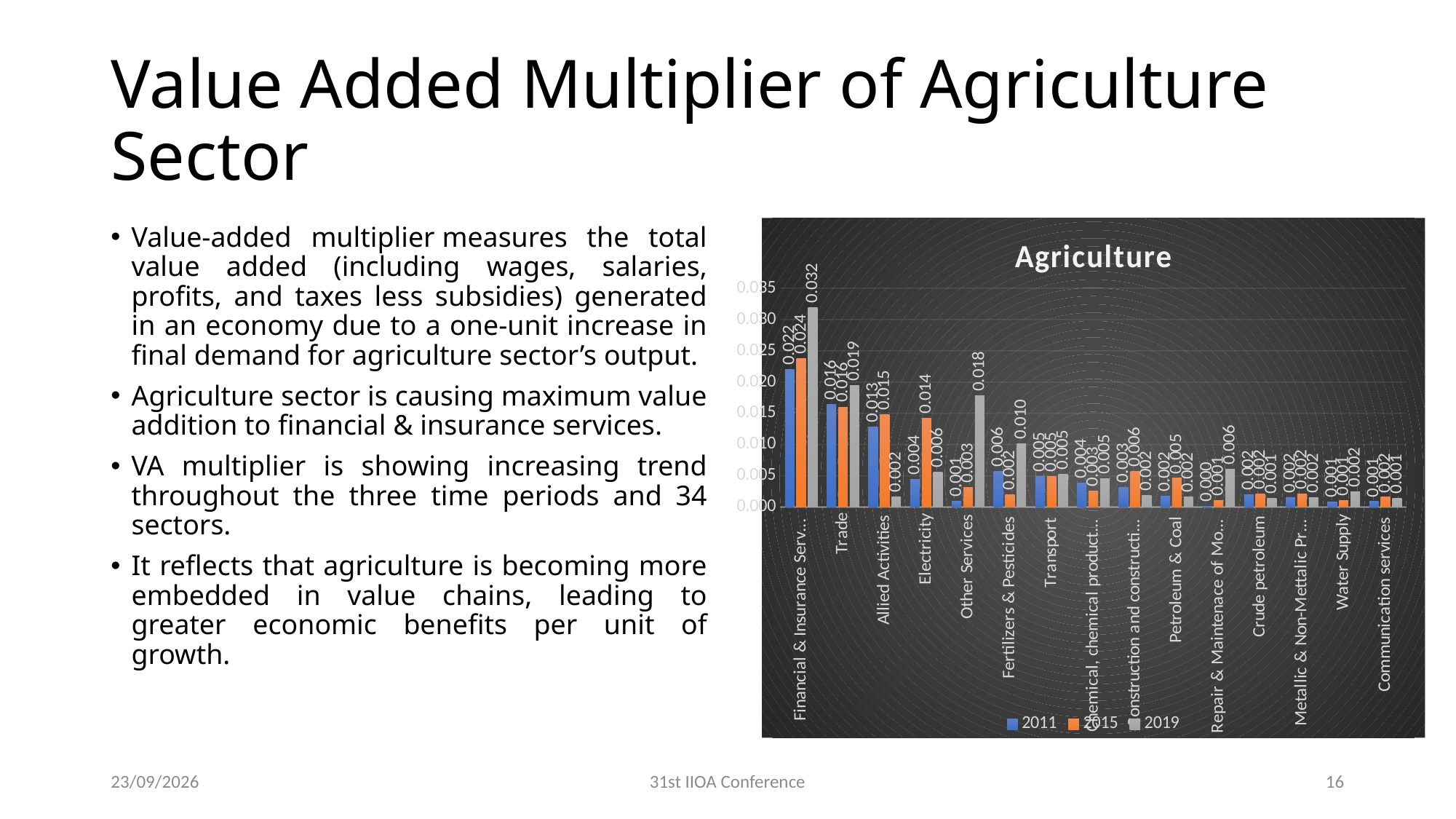
In the Agriculture chart, is the 2019 value for Fertilizers & Pesticides greater or less than 0.005? greater In the Agriculture chart, which is larger for Allied Activities: the 2015 value or the 2019 value? 2015 What is the 2015 value for Electricity in the Agriculture chart? 0.014 What is the difference between the 2019 and 2011 values for Other Services in the Agriculture chart? 0.017 What type of chart is the Agriculture chart? Bar chart What is the 2019 value for Other Services in the Agriculture chart? 0.018 How many categories are shown on the x axis of the Agriculture chart? 15 How many series does the legend of the Agriculture chart list? 3 Which category has the highest 2019 value in the Agriculture chart? Financial & Insurance Services Which years are listed in the legend of the Agriculture chart? 2011, 2015, 2019 What is the 2011 value for Fertilizers & Pesticides in the Agriculture chart? 0.006 What is the 2019 value for Trade in the Agriculture chart? 0.019